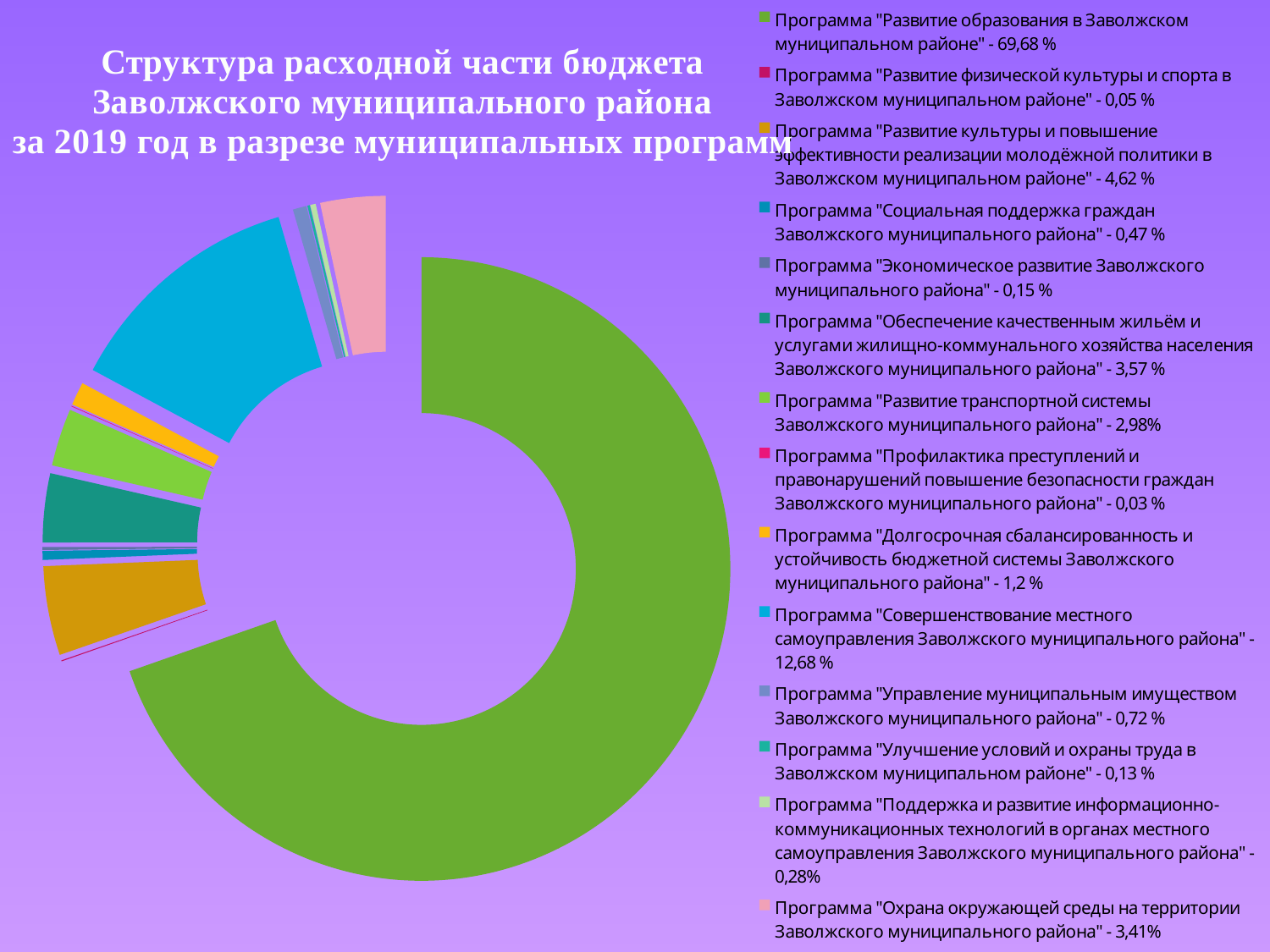
What share is shown for the programme "Долгосрочная сбалансированность и устойчивость бюджетной системы Заволжского муниципального района"? 1,2 % What is the difference in share between the programme "Совершенствование местного самоуправления" (12,68 %) and the programme "Развитие культуры и повышение эффективности реализации молодёжной политики" (4,62 %)? 8,06 % What share is shown for the programme "Совершенствование местного самоуправления Заволжского муниципального района"? 12,68 % What kind of chart is shown on the slide? Pie (doughnut) chart Which programme has the smallest share of the budget expenditure? Программа "Профилактика преступлений и правонарушений повышение безопасности граждан Заволжского муниципального района" (0,03 %) What share is shown for the programme "Охрана окружающей среды на территории Заволжского муниципального района"? 3,41% What year does the chart title say the budget expenditure structure refers to? 2019 What share of the budget expenditure goes to the programme "Развитие образования в Заволжском муниципальном районе"? 69,68 % Which programme has the largest share of the budget expenditure? Программа "Развитие образования в Заволжском муниципальном районе" What is the difference in share between the programme "Развитие транспортной системы" (2,98%) and the programme "Управление муниципальным имуществом" (0,72 %)? 2,26 % How many programmes (slices) does the chart show? 14 Which has a larger share: the programme "Развитие культуры и повышение эффективности реализации молодёжной политики" or the programme "Обеспечение качественным жильём и услугами жилищно-коммунального хозяйства населения"? Развитие культуры и повышение эффективности реализации молодёжной политики (4,62 %)